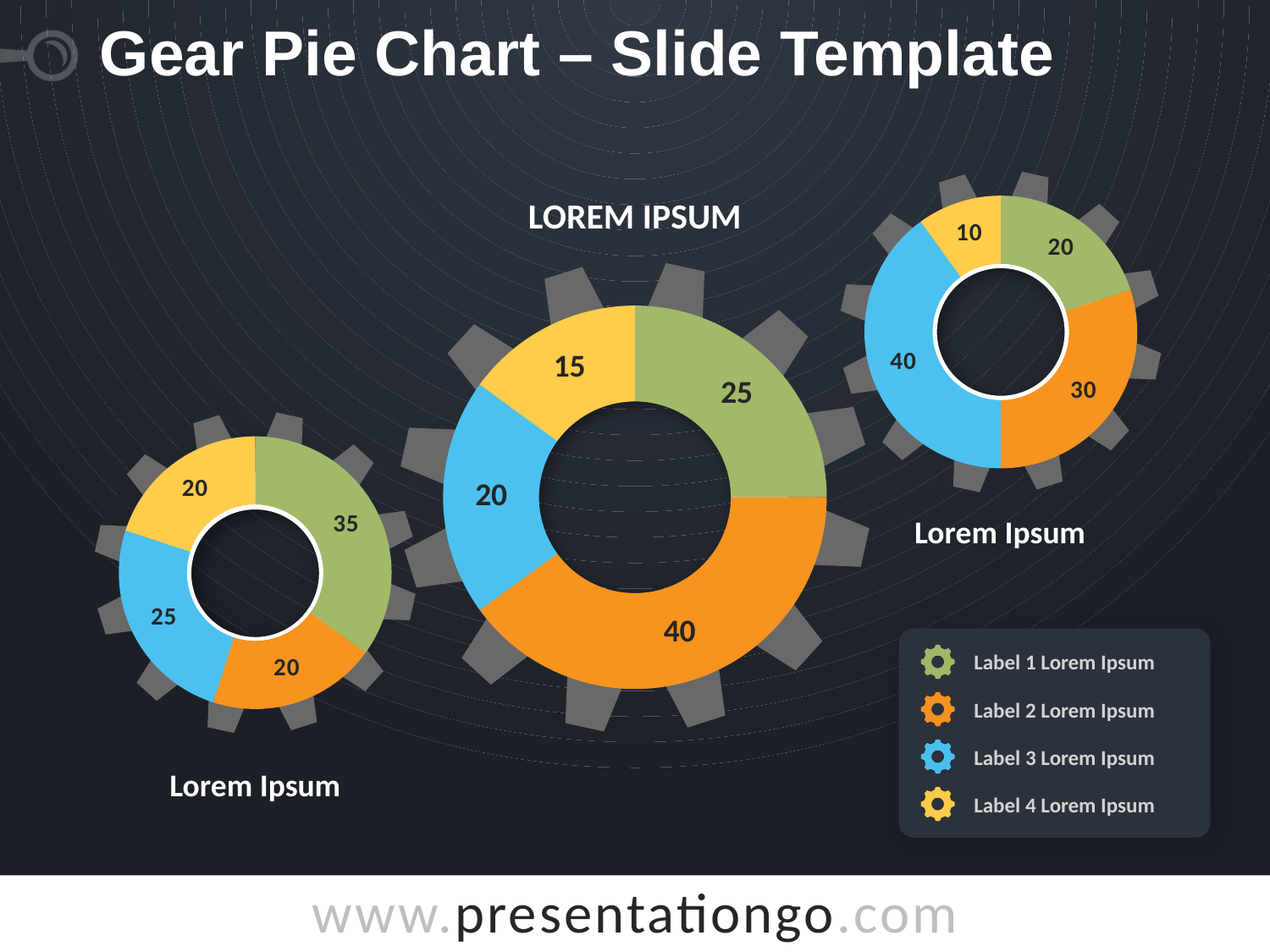
In the right chart, what is the value of the Label 3 Lorem Ipsum (blue) slice? 40 In the right chart, which label has the smallest slice? Label 4 Lorem Ipsum In the center chart, which label has the largest slice? Label 2 Lorem Ipsum What colour represents Label 3 Lorem Ipsum in the legend? Blue How many slices does the left chart have? 4 In the center chart, what is the difference between the Label 2 Lorem Ipsum slice and the Label 4 Lorem Ipsum slice? 25 In the left chart, which label has the largest slice? Label 1 Lorem Ipsum How many entries does the legend list? 4 In the center chart, what is the value of the Label 2 Lorem Ipsum (orange) slice? 40 What kind of chart is the center chart? Pie (donut) chart In the right chart, which is larger: the Label 1 Lorem Ipsum slice or the Label 2 Lorem Ipsum slice? Label 2 Lorem Ipsum In the left chart, what is the value of the Label 1 Lorem Ipsum (green) slice? 35